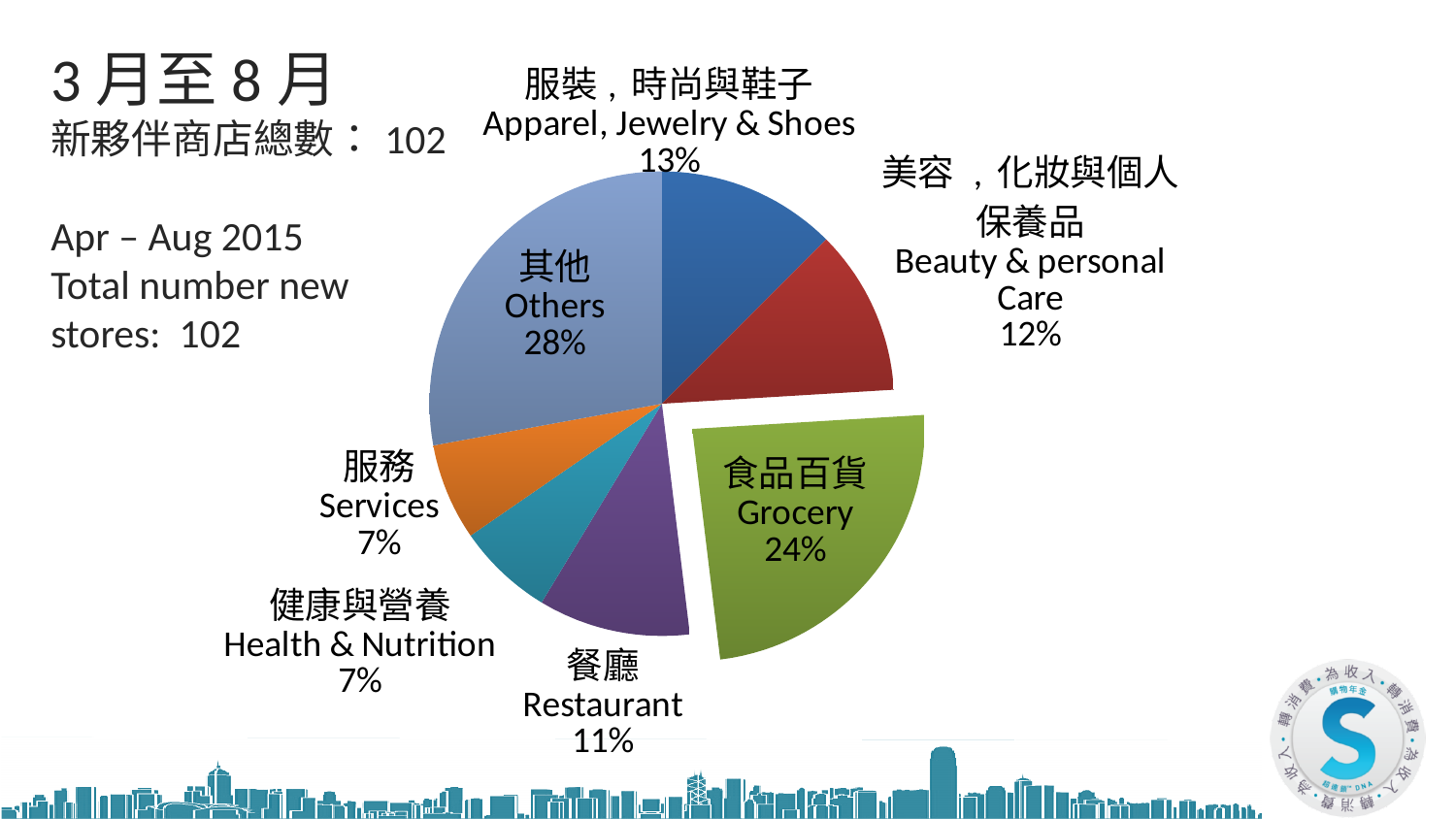
What percentage is shown for Restaurant? 11% Which is larger, the share for Apparel, Jewelry & Shoes or the share for Restaurant? Apparel, Jewelry & Shoes Which slice of the pie is pulled out (exploded) from the rest? Grocery What share of the pie does Grocery represent? 24% Which category has the largest share of the pie? Others What kind of chart is shown on the slide? pie chart What percentage is shown for Apparel, Jewelry & Shoes? 13% What is the difference in percentage points between Others and Grocery? 4 How many categories are shown in the pie chart? 7 What is the total number of new stores stated on the slide? 102 What percentage is shown for Beauty & personal Care? 12% Which categories share the smallest slice of the pie? Services and Health & Nutrition